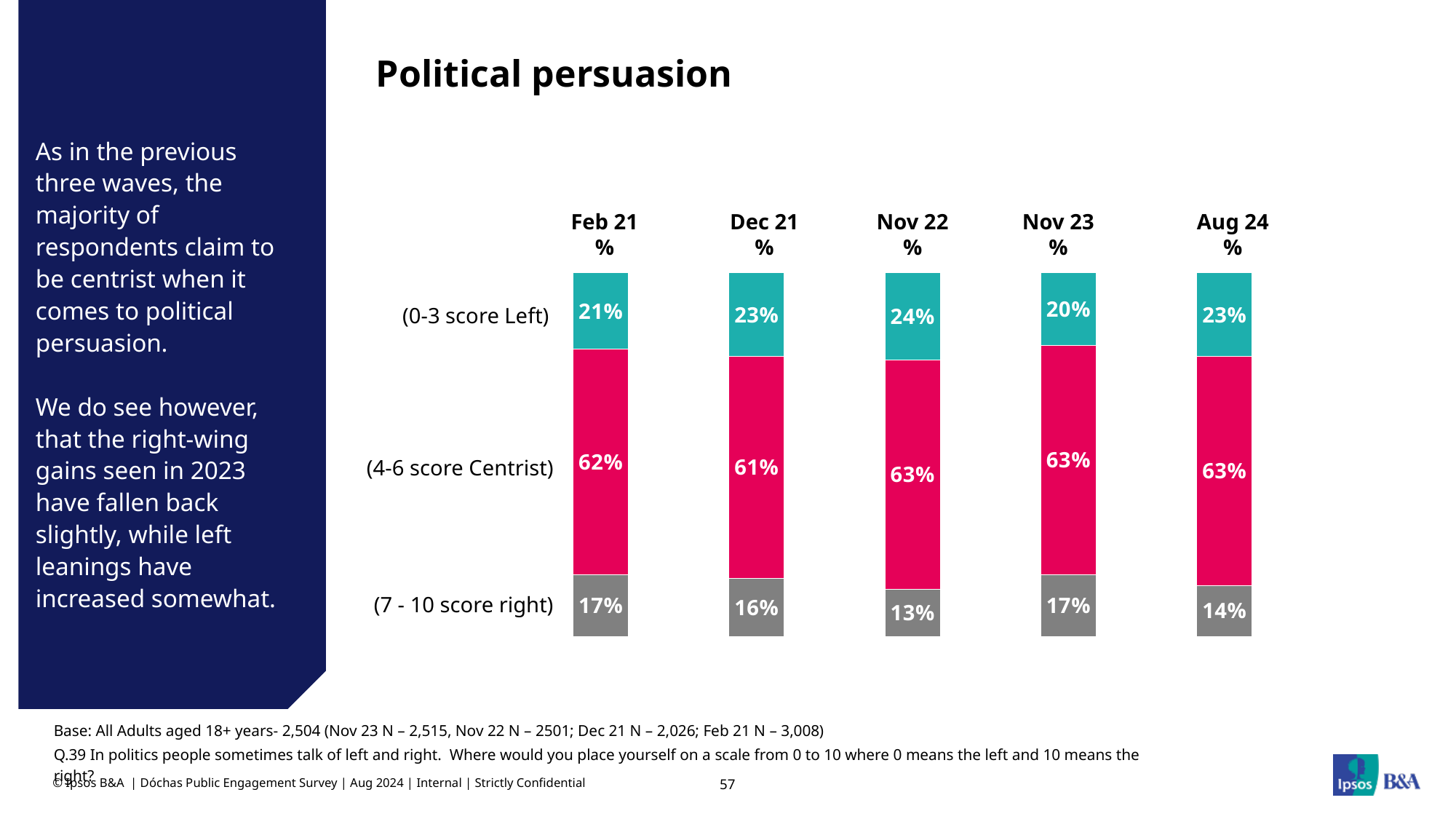
What is the title of the chart? Political persuasion What type of chart is shown on the slide? Stacked bar chart How many political persuasion categories are shown for each wave? 3 In which wave was the share of respondents scoring 0-3 (Left) lowest? Nov 23 How many survey waves are shown in the chart? 5 What is the difference in the 7-10 score right share between Nov 23 and Aug 24? 3 percentage points What percentage of respondents were Centrist (4-6 score) in Dec 21? 61% In which wave was the share of respondents scoring 0-3 (Left) highest? Nov 22 In which wave was the share of respondents scoring 7-10 (right) lowest? Nov 22 Which is larger: the Left (0-3) share in Feb 21 or in Dec 21? Dec 21 What percentage of respondents scored 7-10 (right) in Nov 22? 13% What percentage of respondents scored 0-3 (Left) in Aug 24? 23%